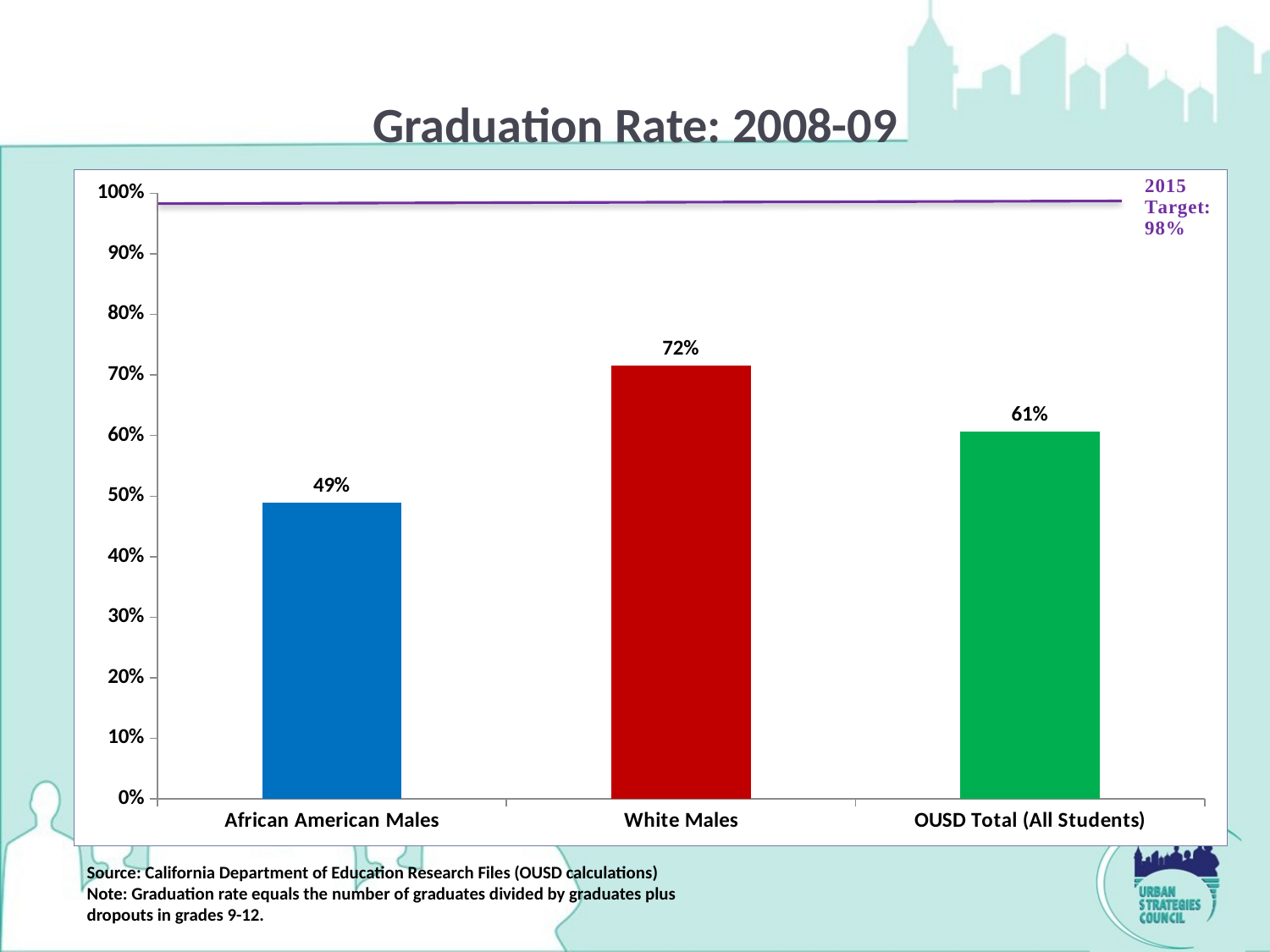
What is the difference between the graduation rates of OUSD Total (All Students) and African American Males? 12% Which category has the highest graduation rate? White Males What is the graduation rate for African American Males? 49% What is the difference between the graduation rates of White Males and African American Males? 23% What is the graduation rate for White Males? 72% How many categories are shown on the x axis? 3 Which is larger, the graduation rate for White Males or for OUSD Total (All Students)? White Males Is the graduation rate for African American Males greater or less than 50%? less What is the 2015 Target value shown by the horizontal line? 98% What is the graduation rate for OUSD Total (All Students)? 61% What kind of chart is shown on the slide? bar chart Which category has the lowest graduation rate? African American Males